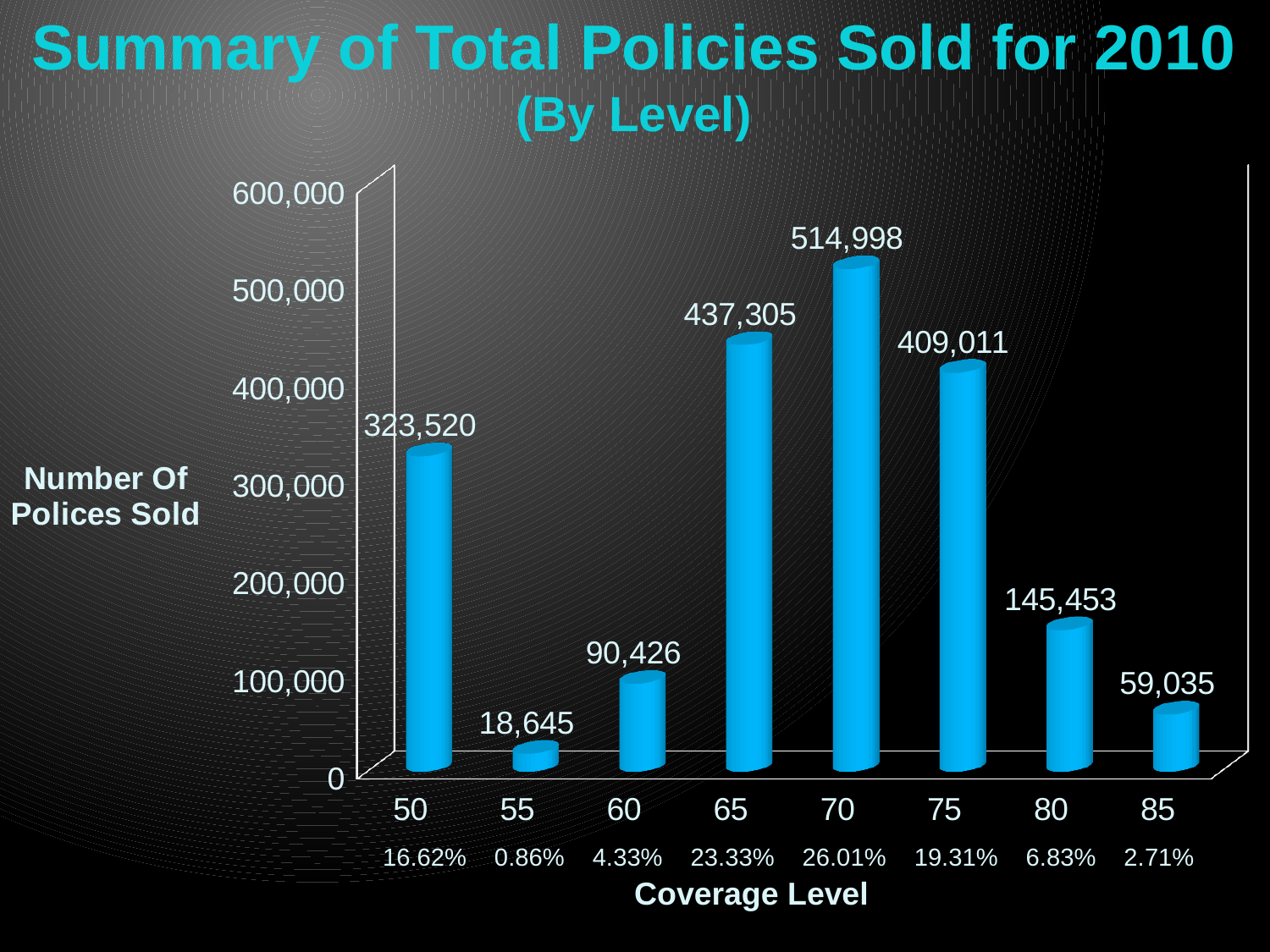
What type of chart is shown on the slide? bar chart What is the difference in policies sold between coverage level 65 and coverage level 75? 28,294 How many policies were sold at coverage level 70? 514,998 Is the number of policies sold at coverage level 60 greater or less than 100,000? less Which coverage level had more policies sold, 50 or 85? 50 What is the label of the vertical axis? Number Of Polices Sold What percentage of total policies sold is shown under coverage level 70? 26.01% How many policies were sold at coverage level 80? 145,453 How many policies were sold at coverage level 55? 18,645 Which coverage level has the lowest number of policies sold? 55 Which coverage level has the highest number of policies sold? 70 How many coverage levels are shown on the chart? 8